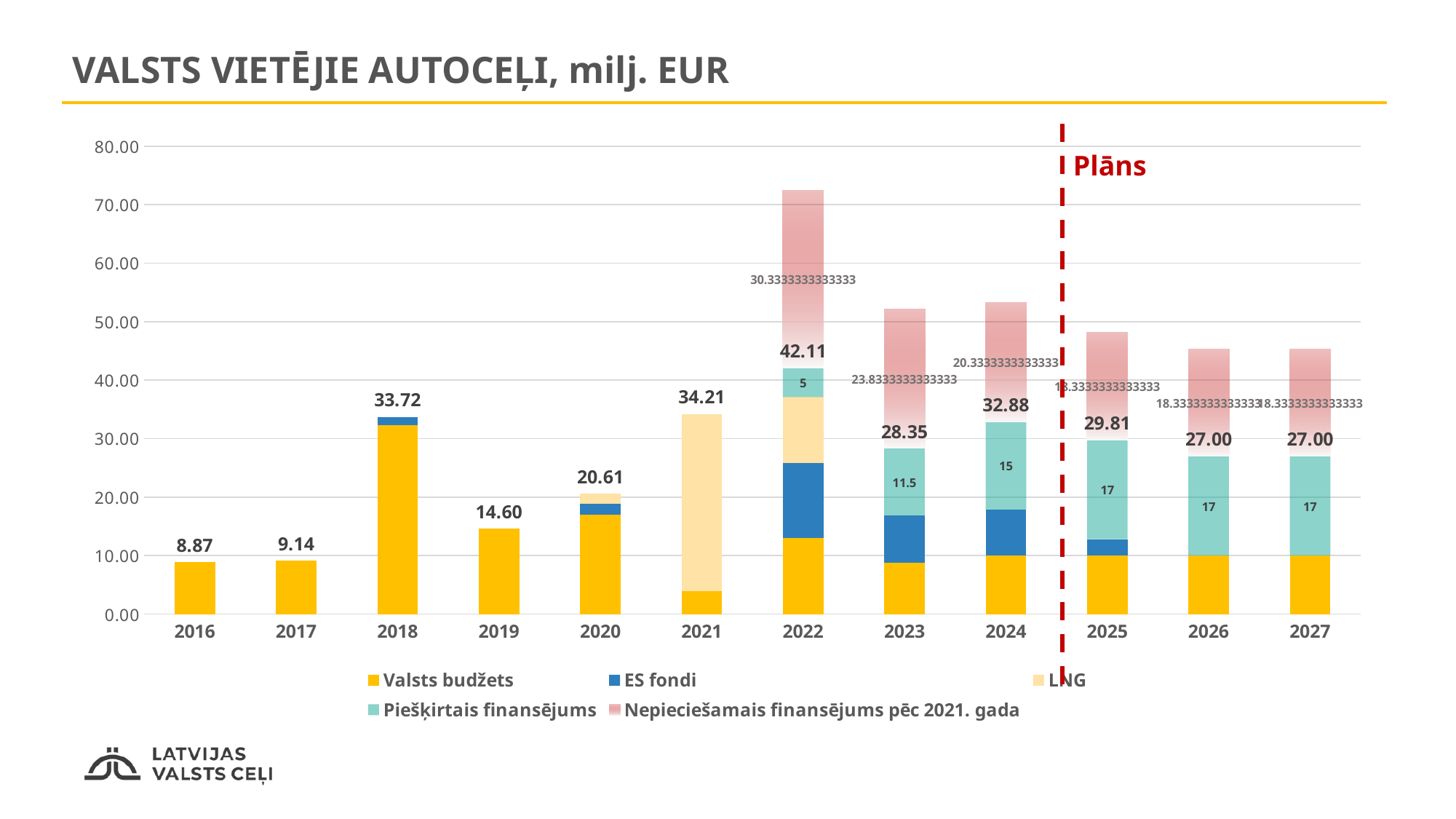
What is the value of the Nepieciešamais finansējums pēc 2021. gada segment in 2022? 30.3333333333333 What value is labelled on the bar for 2016? 8.87 How many series does the legend list? 5 Which year has the highest bold value label on its bar? 2022 What value is labelled on the bar for 2018? 33.72 What is the value of the Piešķirtais finansējums segment in 2024? 15 Which year has the lowest bold value label on its bar? 2016 What value is labelled on the bar for 2021? 34.21 What kind of chart is shown on the slide? Stacked bar chart How many years are shown on the x axis? 12 What word is written next to the red dashed vertical line? Plāns What is the difference between the bold labels for 2018 and 2019? 19.12